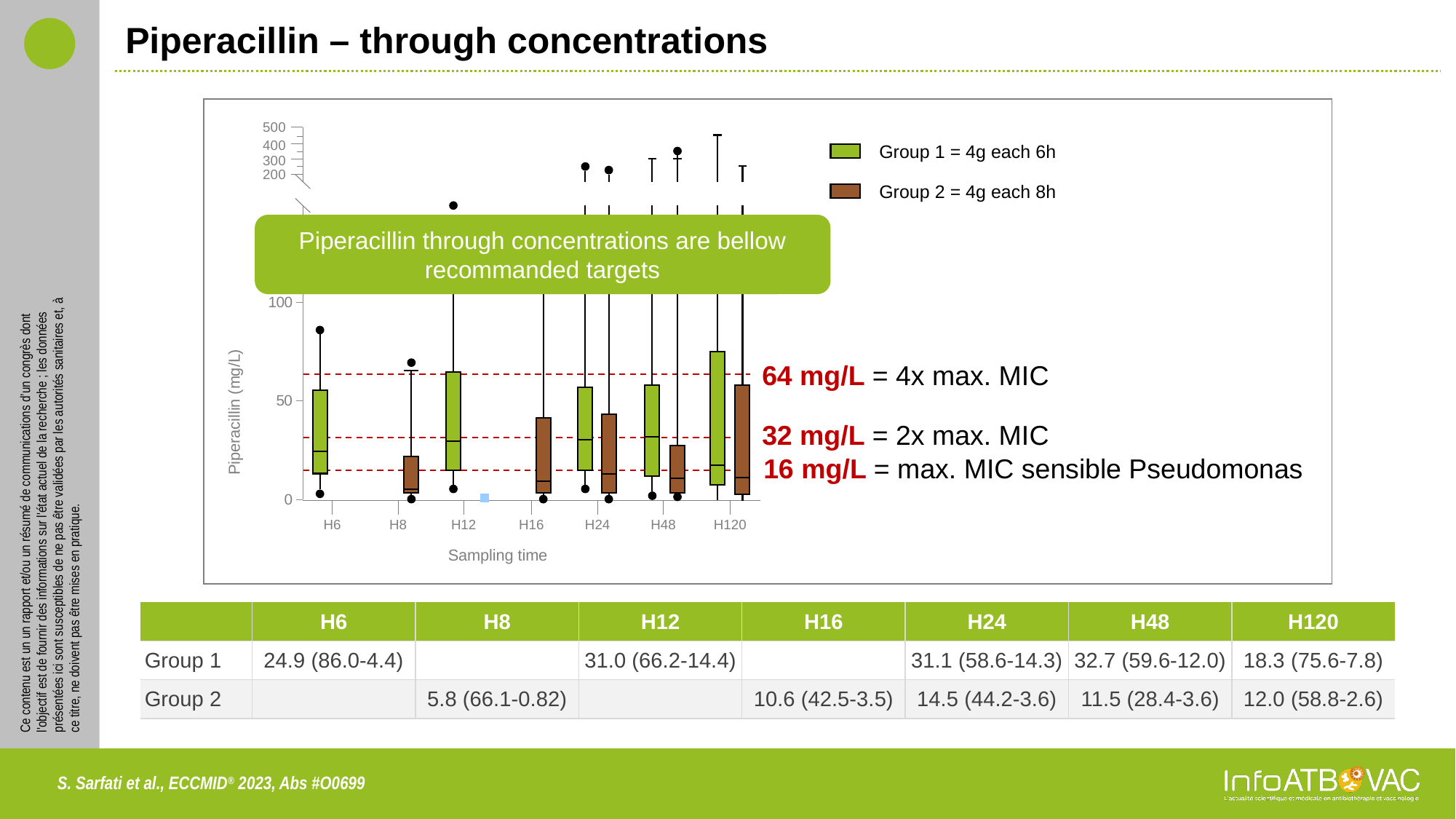
How many sampling times are shown on the x axis of the chart? 7 How many groups does the chart legend list? 2 What kind of chart is shown on the slide? Box plot Is the Group 1 median concentration at H6 greater or less than 50 mg/L? less According to the legend, what is the dosing regimen for Group 1? 4g each 6h What is the median piperacillin concentration for Group 2 at H8, as printed in the table? 5.8 (66.1-0.82) At H120, which group has the higher median piperacillin concentration? Group 1 What is the median piperaciillin concentration for Group 1 at H6, as printed in the table? 24.9 (86.0-4.4) What is the difference between the Group 1 and Group 2 median concentrations at H48? 21.2 At which sampling time is the Group 2 median concentration lowest? H8 Do the Group 2 median concentrations rise or fall from H8 to H24? rise At which sampling time is the Group 1 median concentration highest? H48